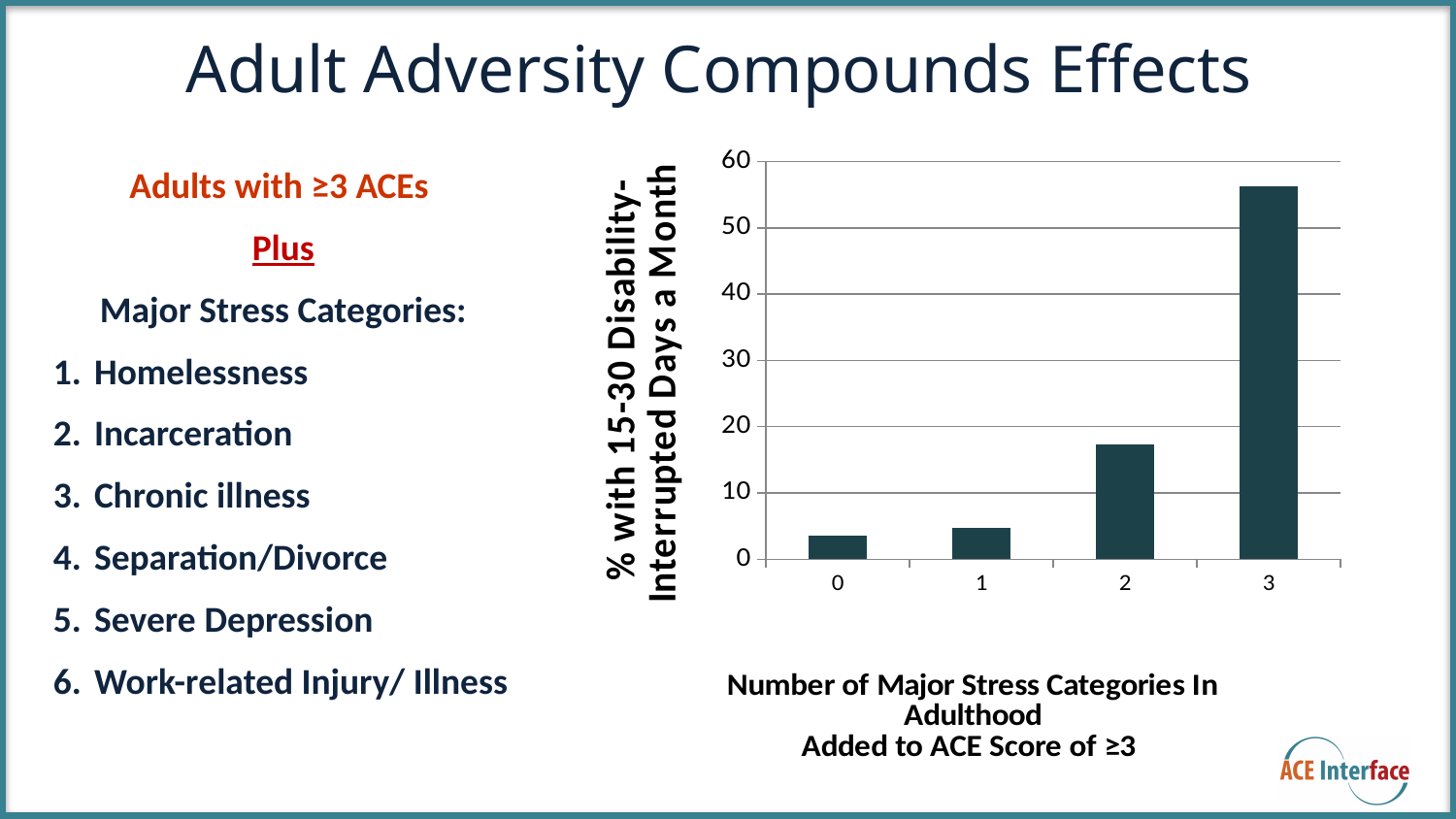
What kind of chart is shown on the slide? bar chart Do the values rise or fall as the number of major stress categories increases from 0 to 3? rise Which number of major stress categories has the highest percentage with 15-30 disability-interrupted days a month? 3 Is the value for 2 major stress categories greater or less than 20? less Which has a larger value: 2 major stress categories or 3 major stress categories? 3 Is the value for 0 major stress categories greater or less than 10? less Is the value for 1 major stress category greater or less than 10? less How many bars (categories) are plotted on the chart? 4 Which has a larger value: 1 major stress category or 2 major stress categories? 2 What is the label of the chart's vertical axis? % with 15-30 Disability-Interrupted Days a Month